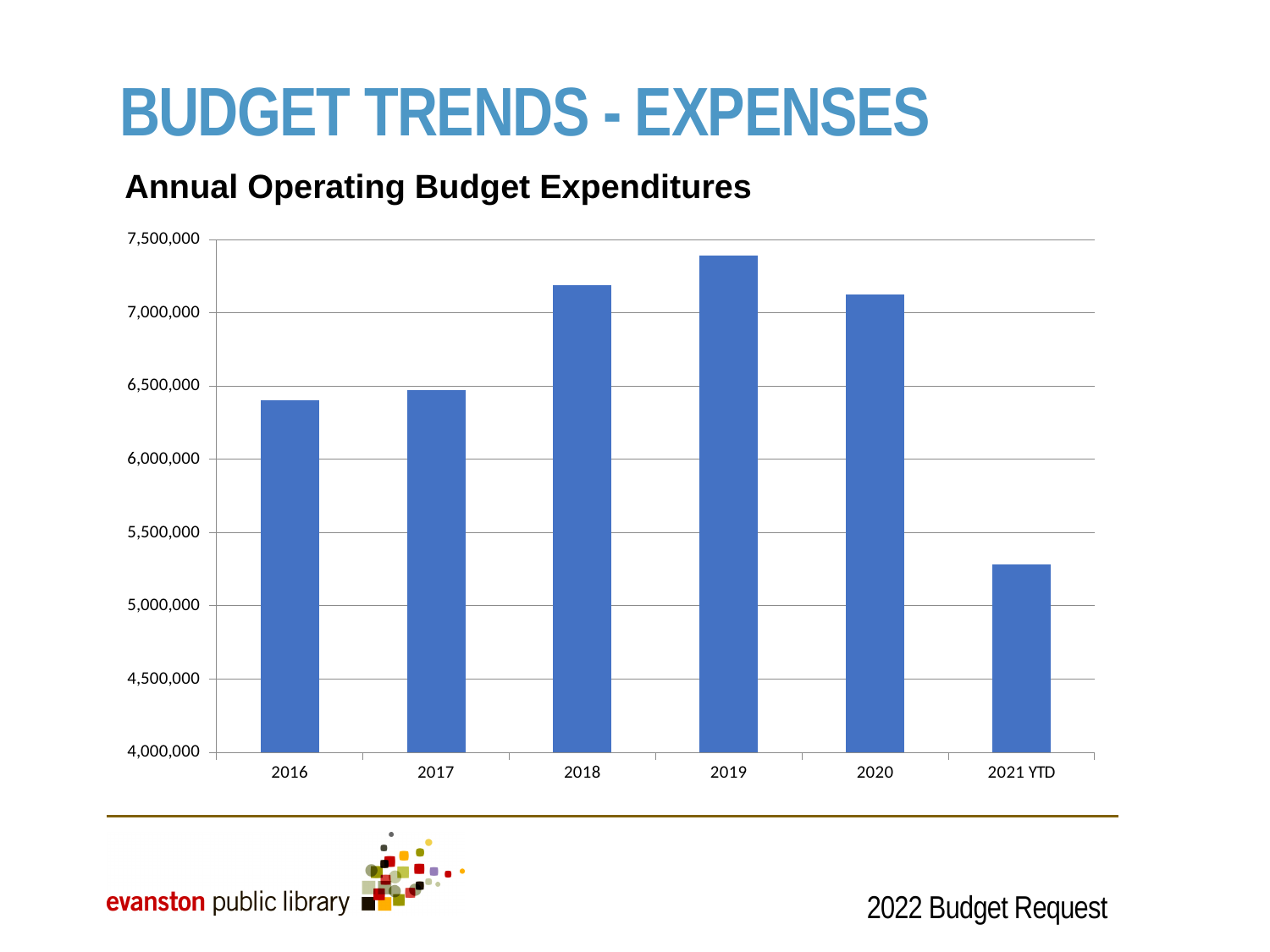
What kind of chart is shown on the slide? Bar chart Which year has higher expenditures, 2019 or 2020? 2019 Is the value for 2021 YTD greater or less than 5,500,000? less Is the value for 2016 greater or less than 6,500,000? less Which year has the highest annual operating budget expenditures? 2019 How many years (categories) are plotted on the x axis? 6 Is the value for 2018 greater or less than 7,000,000? greater Which year has higher expenditures, 2016 or 2018? 2018 Which category has the lowest annual operating budget expenditures? 2021 YTD How do the expenditures change from 2016 to 2019? They rise each year What is the title of the chart? Annual Operating Budget Expenditures